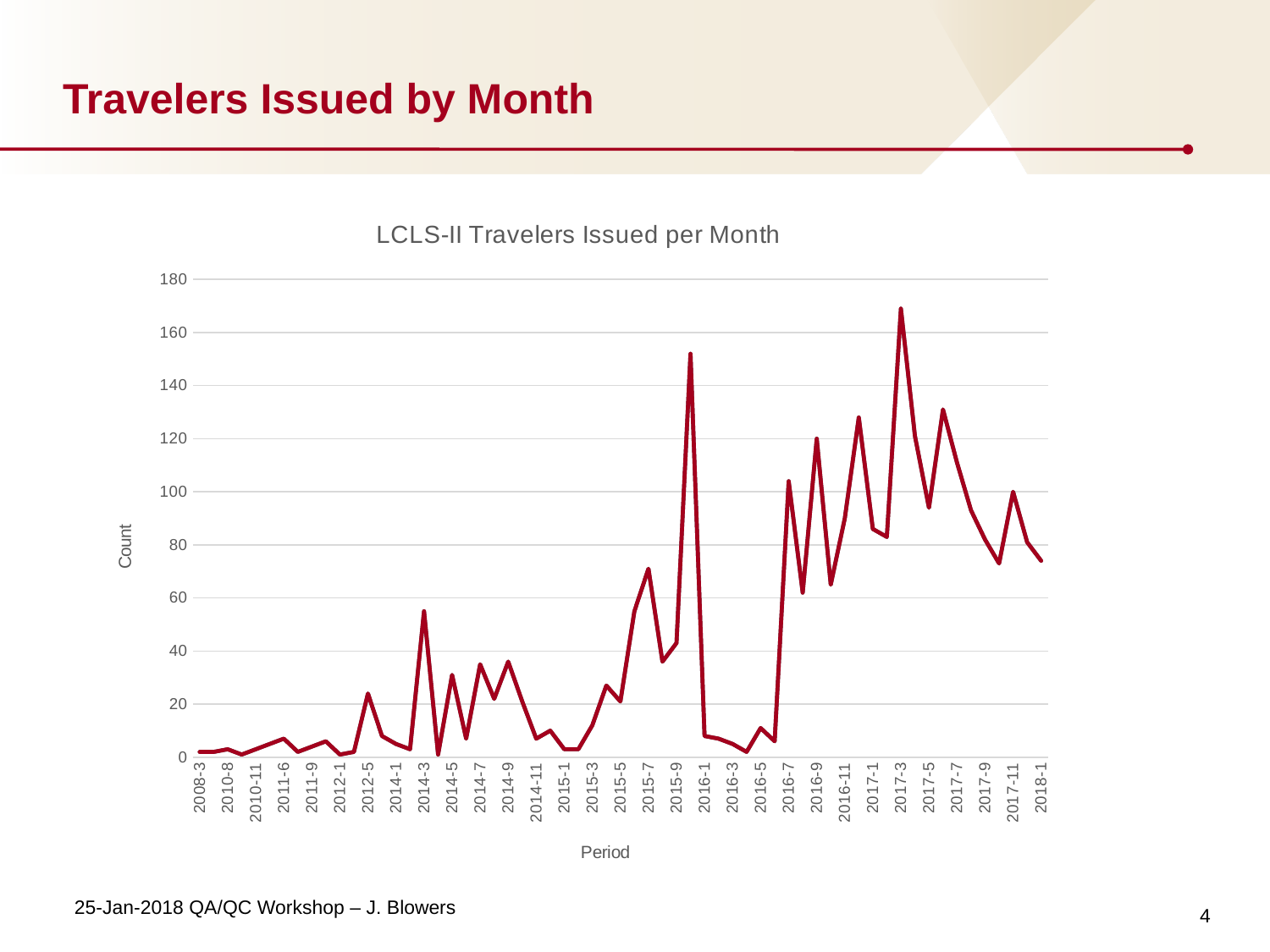
What kind of chart is shown on the slide? line chart Which period has the highest count? 2017-3 Is the value for 2008-3 greater or less than 20? less Is the value for 2018-1 greater or less than 80? less Is the value for 2016-3 greater or less than 20? less What is the label of the vertical axis? Count Overall, do the counts rise or fall from 2008-3 to 2018-1? rise What is the title of the chart? LCLS-II Travelers Issued per Month Which has the larger count, 2017-3 or 2017-7? 2017-3